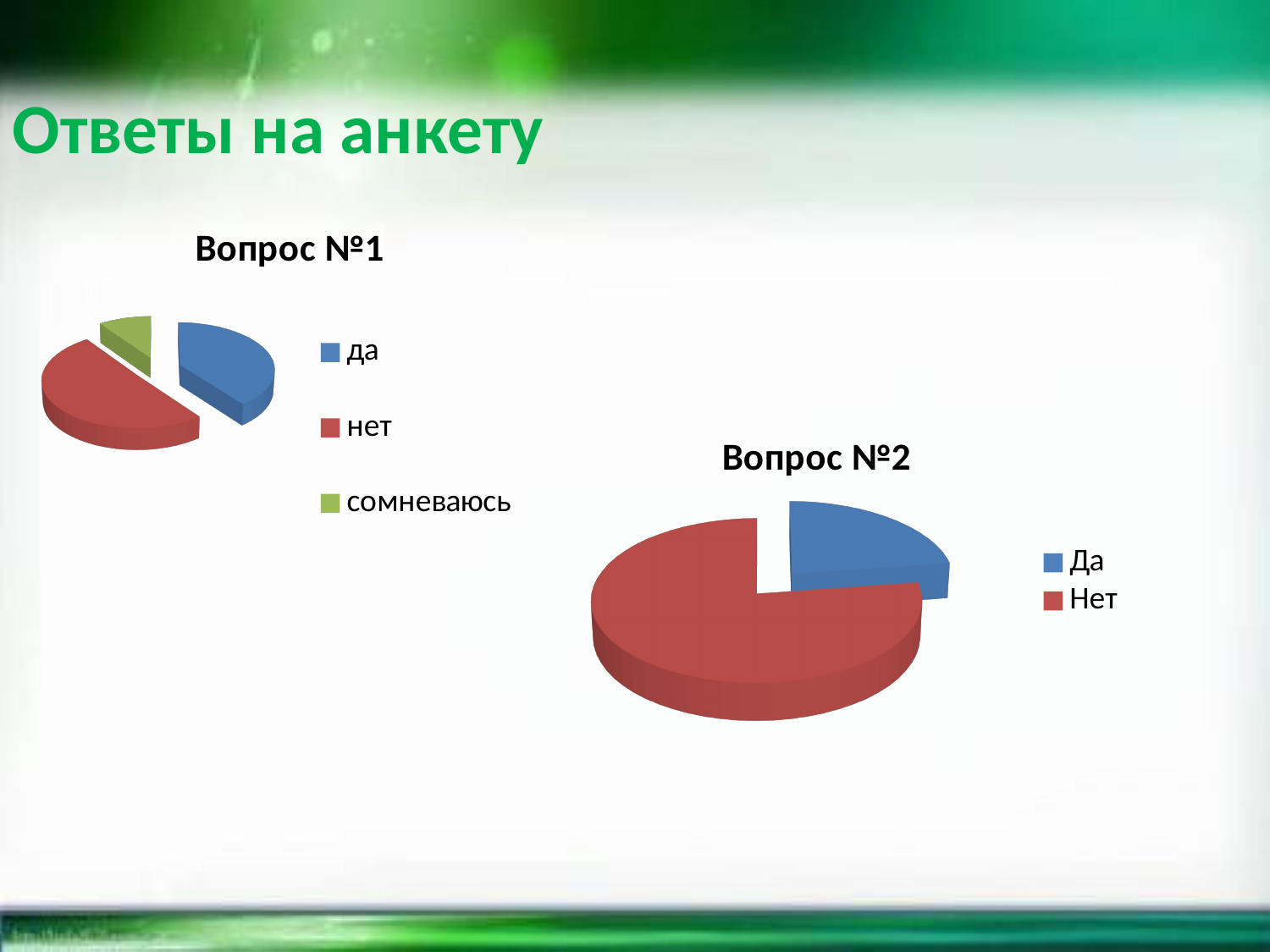
In the chart titled "Вопрос №2", which category has the largest slice? Нет In the chart titled "Вопрос №2", which category has the smallest slice? Да In the chart titled "Вопрос №1", what colour is the "сомневаюсь" slice? green How many charts are shown on the slide? 2 In the chart titled "Вопрос №1", which category has the largest slice? нет In the chart titled "Вопрос №1", which category has the smallest slice? сомневаюсь In the chart titled "Вопрос №1", how many slices does the pie have? 3 In the chart titled "Вопрос №1", which slice is larger, "да" or "нет"? нет What kind of chart is the chart titled "Вопрос №2"? pie chart What kind of chart is the chart titled "Вопрос №1"? pie chart In the chart titled "Вопрос №2", which slice is larger, "Да" or "Нет"? Нет In the chart titled "Вопрос №2", how many slices does the pie have? 2